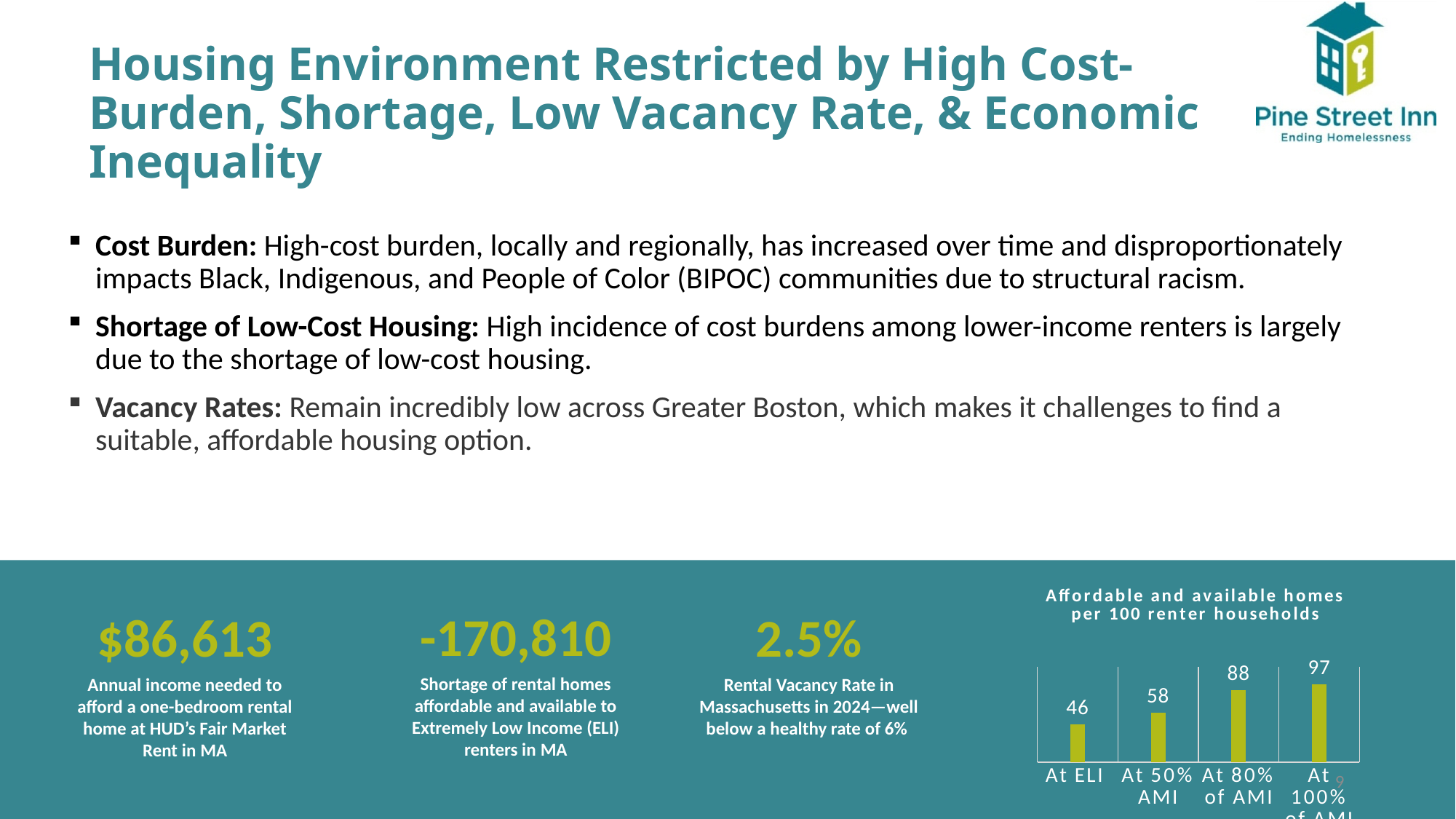
What type of chart is shown on the slide? bar chart What is the value for At 50% AMI? 58 What is the title of the chart on the slide? Affordable and available homes per 100 renter households Do the values rise or fall from left to right across the categories? rise What is the difference between the values for At 80% of AMI and At ELI? 42 Which category has the lowest value? At ELI Which is larger, the value for At 50% AMI or the value for At 80% of AMI? At 80% of AMI What is the value for At 100% of AMI? 97 How many categories does the chart show? 4 What is the value for At ELI? 46 Which category has the highest value? At 100% of AMI What is the value for At 80% of AMI? 88